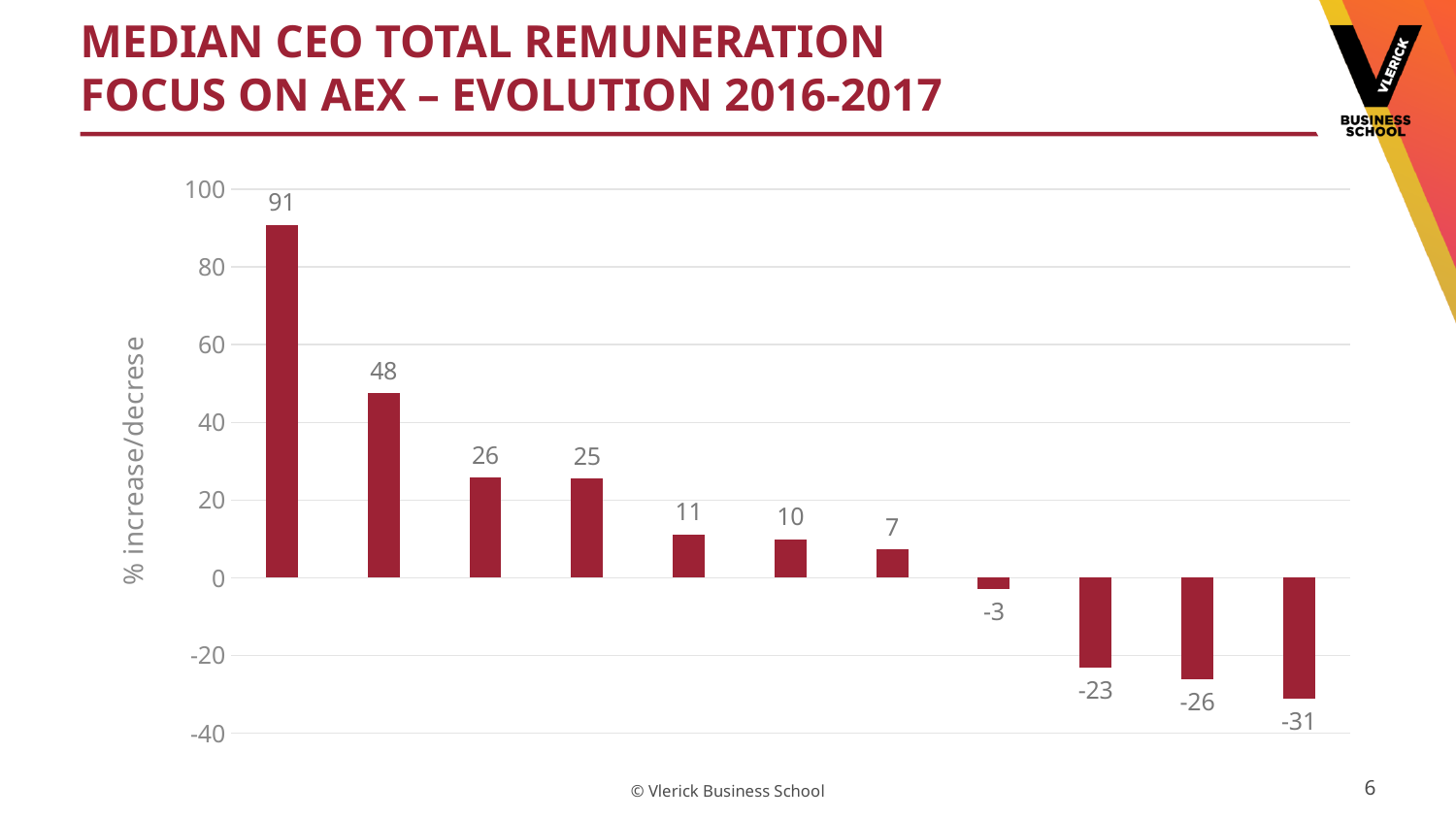
How many bars in the chart have a negative value? 4 How many bars are plotted in the chart? 11 What is the value of the second bar from the left? 48 What is the value of the leftmost bar in the chart? 91 What kind of chart is shown on the slide? Bar chart Do the bar values rise or fall moving from left to right along the x axis? Fall What is the value of the rightmost bar in the chart? -31 What is the difference between the highest value (91) and the second-highest value (48)? 43 What is the highest value shown in the chart? 91 What is the label on the vertical axis of the chart? % increase/decrese What is the lowest value shown in the chart? -31 Which is larger, the value of the third bar from the left or the value of the fourth bar from the left? The third bar (26)